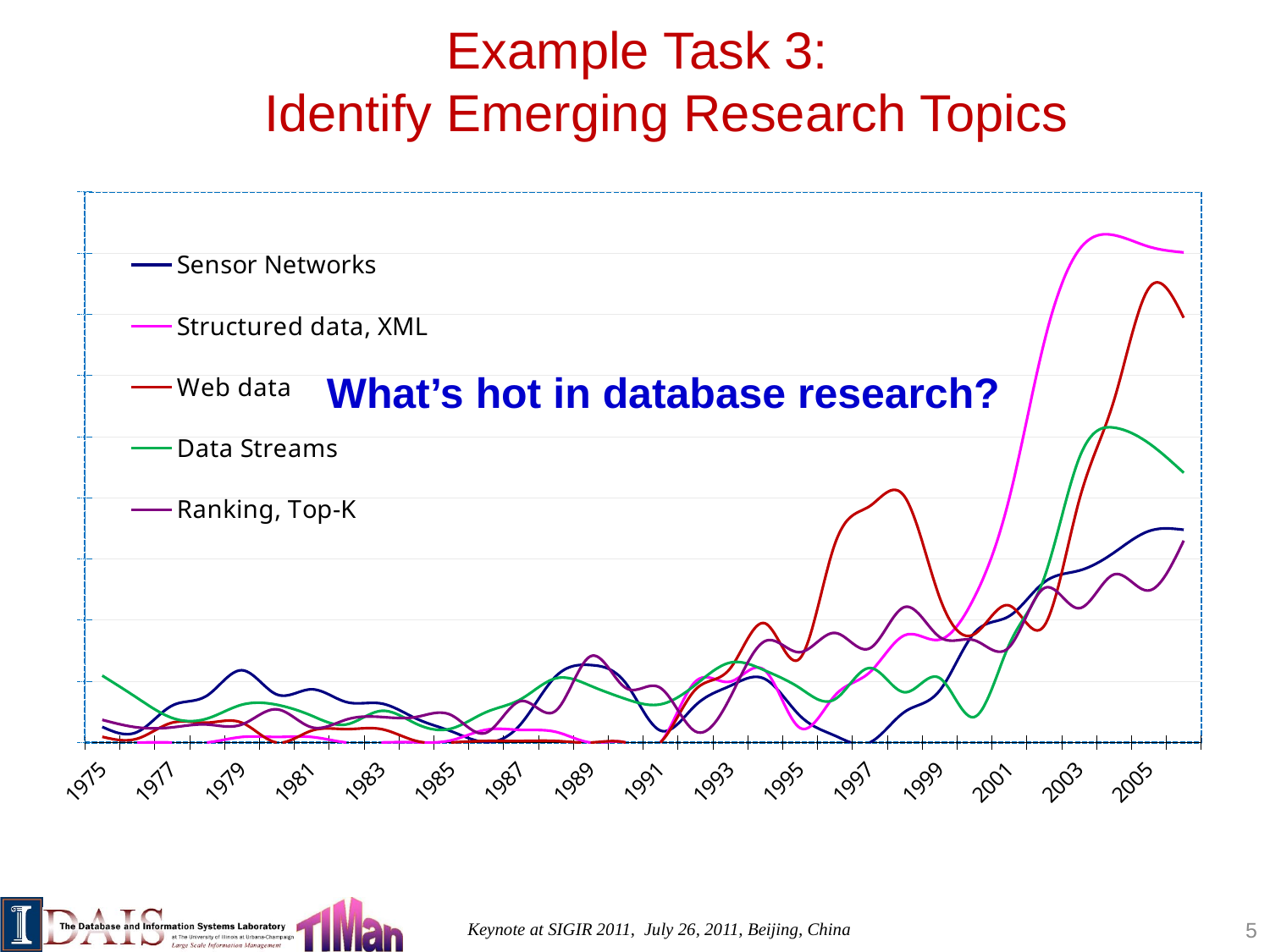
Which series is the highest at the right end of the chart (around 2005)? Structured data, XML Does the Web data line rise or fall between 2001 and 2004? rise At the right end of the chart, which is higher: Data Streams or Sensor Networks? Data Streams Does the Structured data, XML line rise or fall between 1999 and 2003? rise Around 1998, which is higher: Web data or Sensor Networks? Web data How many series does the legend list? 5 At the right end of the chart, which is higher: Web data or Data Streams? Web data Which series is drawn in green in the legend? Data Streams How many year labels are shown on the x axis? 16 What kind of chart is shown on the slide? line chart What is the first year label on the x axis? 1975 Which series has the highest peak around 1997-1998? Web data